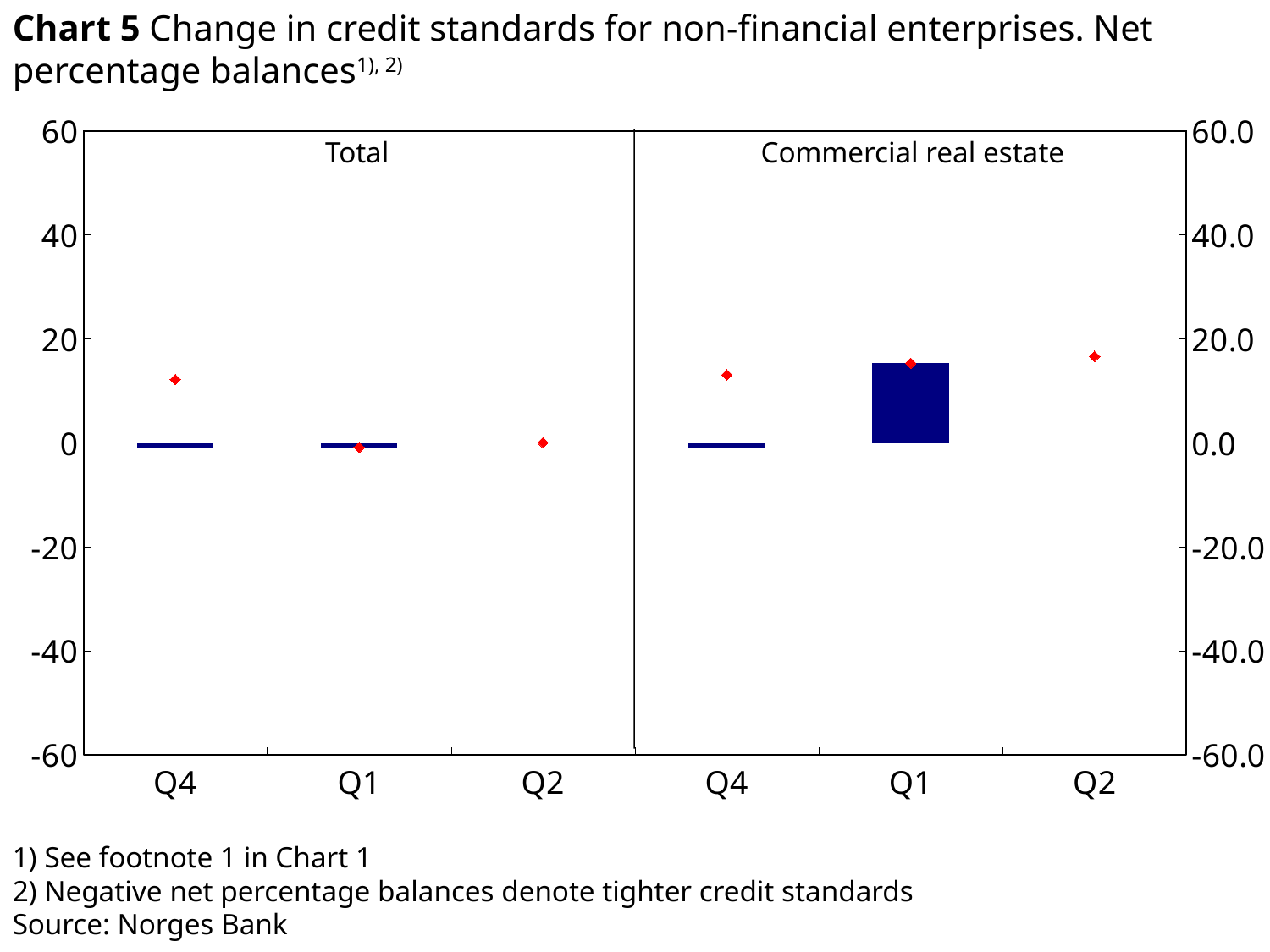
How many panels does Chart 5 have, and what are they labelled? 2: Total and Commercial real estate Is the red marker for Q4 in the Total panel greater or less than 0? greater What is the source given for Chart 5? Norges Bank What kind of chart is Chart 5? combination chart: bars with red diamond markers How many quarters are shown on the x axis of the Total panel? 3 Do the red markers in the Commercial real estate panel rise or fall from Q4 to Q2? rise Is the red marker for Q2 in the Commercial real estate panel greater or less than 40? less Is the bar for Q1 in the Commercial real estate panel greater or less than 20? less Which is larger: the red marker for Q2 in the Total panel or the red marker for Q2 in the Commercial real estate panel? Q2 in the Commercial real estate panel Which bar in Chart 5 is the highest? Q1 in the Commercial real estate panel